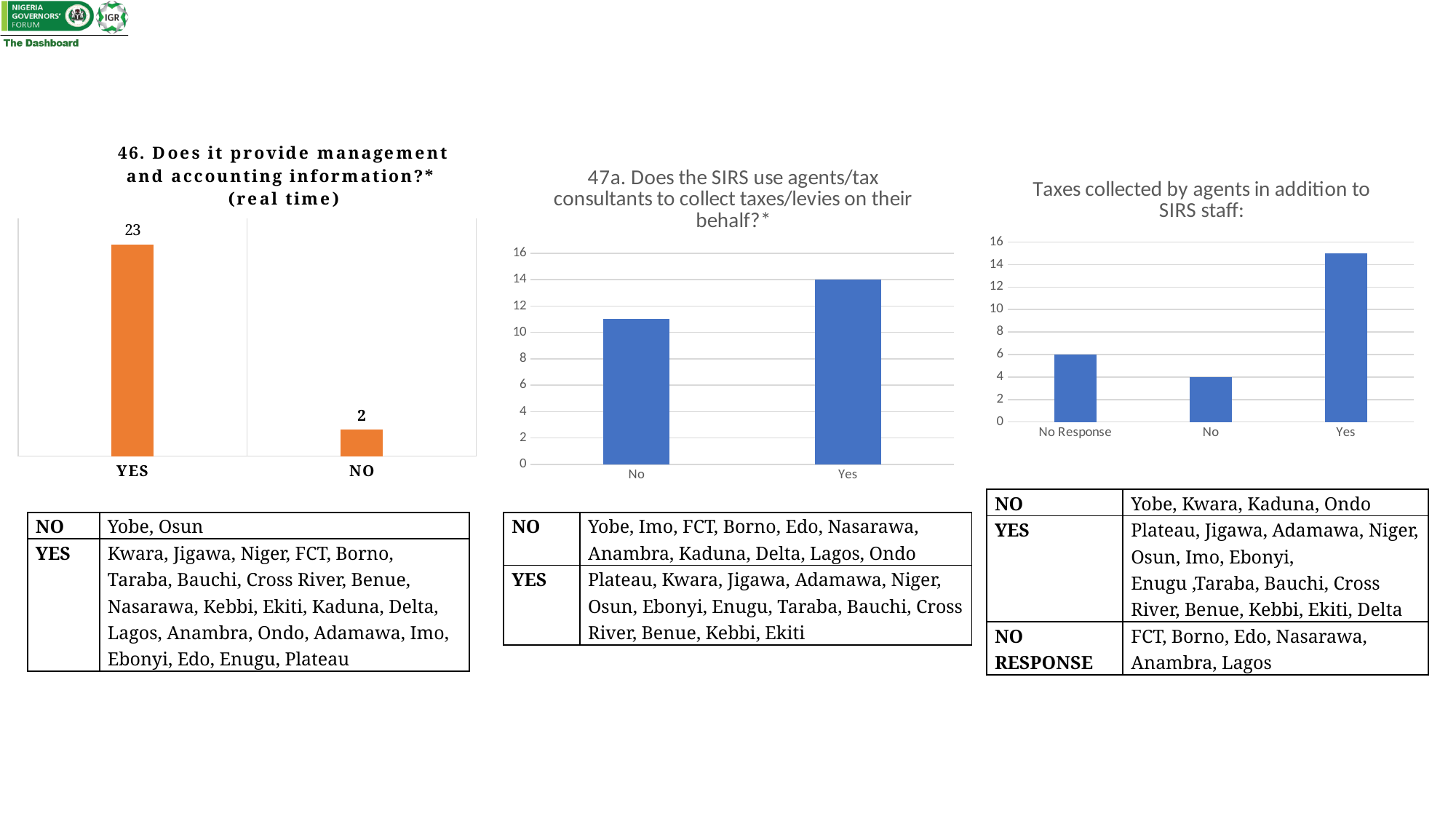
In the chart titled "47a. Does the SIRS use agents/tax consultants to collect taxes/levies on their behalf?", what is the value for Yes? 14 In the chart titled "Taxes collected by agents in addition to SIRS staff", how many categories are shown on the x axis? 3 In the chart titled "47a. Does the SIRS use agents/tax consultants to collect taxes/levies on their behalf?", which category has the lowest value? No In the chart titled "Taxes collected by agents in addition to SIRS staff", is the value for Yes greater or less than 14? greater In the chart titled "46. Does it provide management and accounting information?", which category has the highest value? YES What kind of chart is the chart titled "Taxes collected by agents in addition to SIRS staff"? bar chart In the chart titled "47a. Does the SIRS use agents/tax consultants to collect taxes/levies on their behalf?", is the value for No greater or less than 10? greater In the chart titled "46. Does it provide management and accounting information?", what is the value for YES? 23 In the chart titled "46. Does it provide management and accounting information?", what is the value for NO? 2 In the chart titled "Taxes collected by agents in addition to SIRS staff", what is the value for No? 4 In the chart titled "46. Does it provide management and accounting information?", what is the difference between the YES and NO values? 21 In the chart titled "Taxes collected by agents in addition to SIRS staff", what is the value for No Response? 6